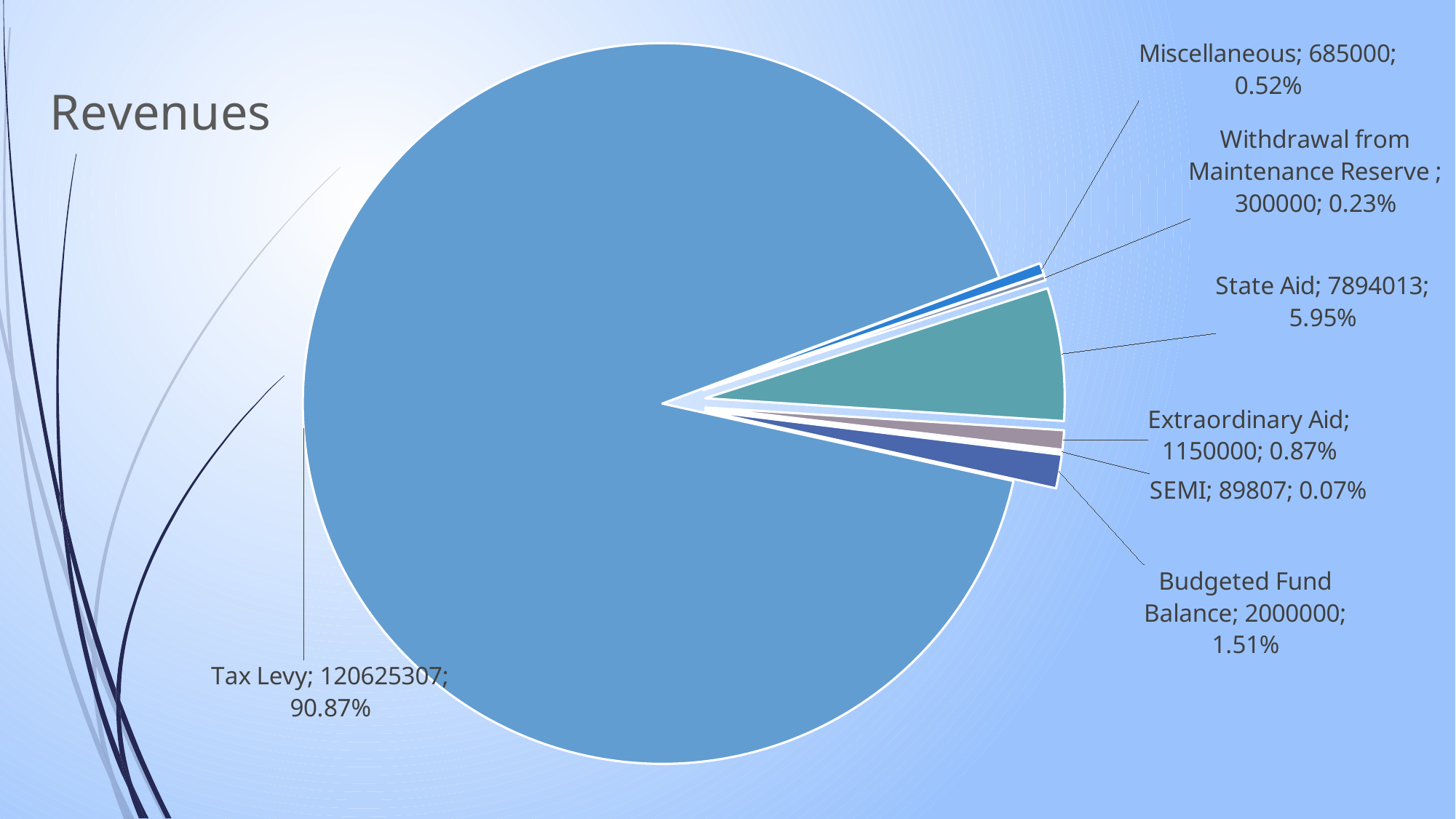
What is the value for Tax Levy? 120625307 What type of chart is shown on the slide? Pie chart What share of the pie does Extraordinary Aid represent? 0.87% Which category has the largest slice? Tax Levy What is the value for State Aid? 7894013 Which category has the smallest slice? SEMI What is the difference between the values for Budgeted Fund Balance and Extraordinary Aid? 850000 How many categories are shown in the pie chart? 7 What share of the pie does State Aid represent? 5.95% Which is larger, the value for Miscellaneous or the value for Withdrawal from Maintenance Reserve? Miscellaneous What is the value for Budgeted Fund Balance? 2000000 What is the value for SEMI? 89807